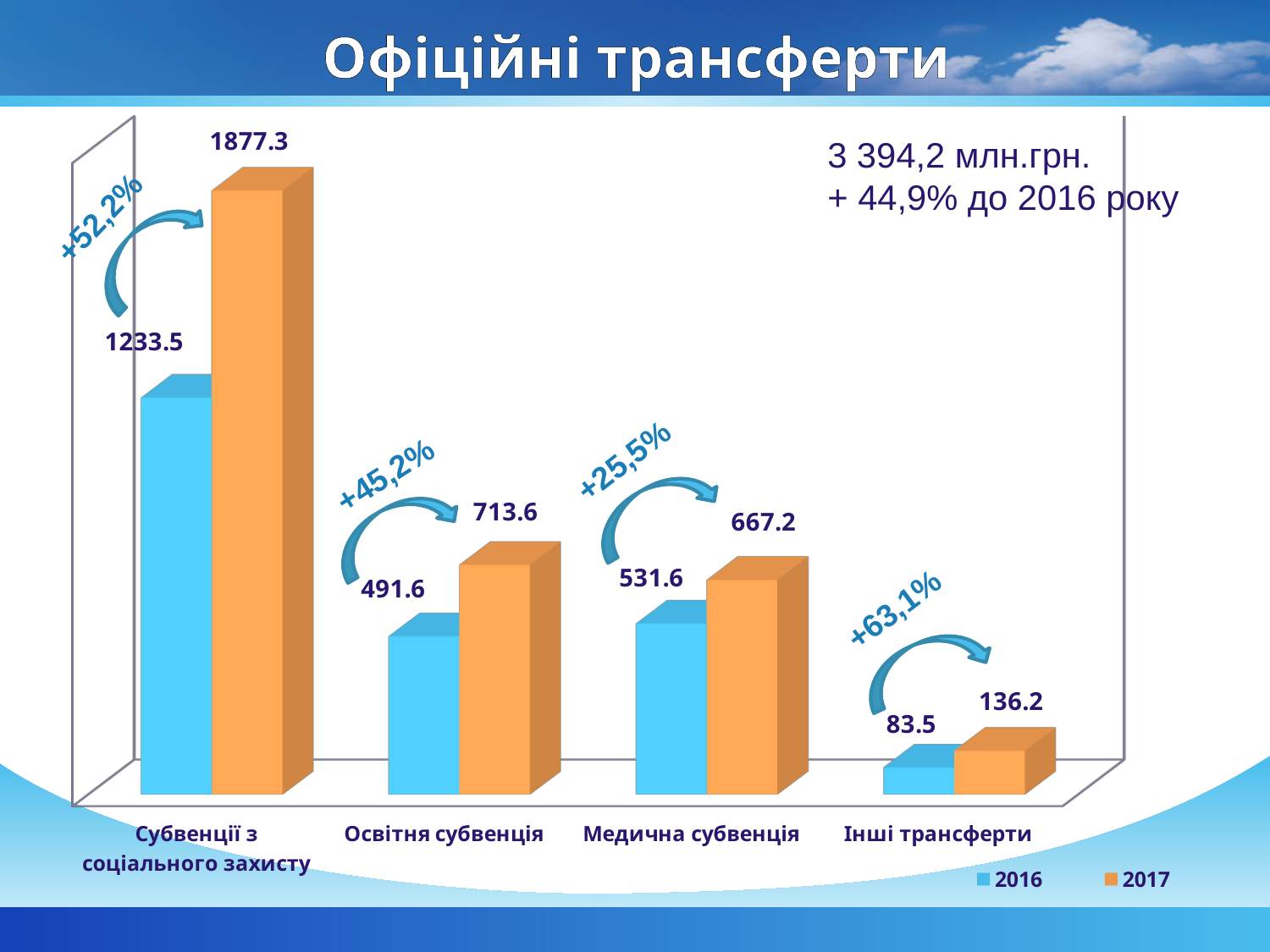
What is the 2017 value for Субвенції з соціального захисту? 1877.3 How many categories are shown on the x axis? 4 What is the difference between the 2017 and 2016 values for Інші трансферти? 52.7 What is the difference between the 2017 and 2016 values for Субвенції з соціального захисту? 643.8 What is the 2016 value for Освітня субвенція? 491.6 What is the 2017 value for Інші трансферти? 136.2 What is the 2016 value for Медична субвенція? 531.6 Which category has the highest 2017 value? Субвенції з соціального захисту What kind of chart is shown on the slide? Bar chart Which is larger in 2016: Освітня субвенція or Медична субвенція? Медична субвенція How many series does the legend list? 2 Which category has the lowest 2016 value? Інші трансферти